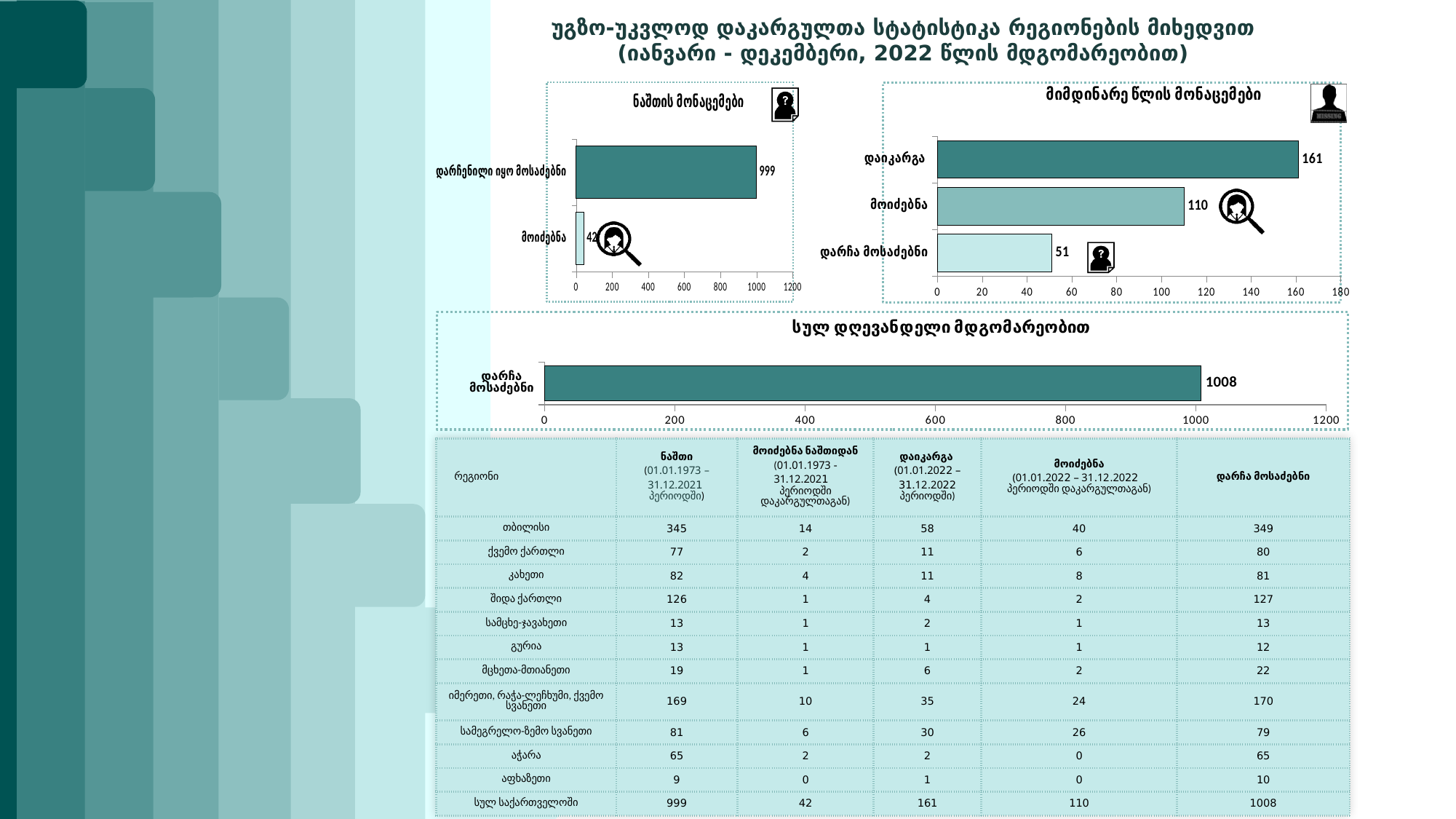
In the top-left chart titled "ნაშთის მონაცემები", what is the value for "მოიძებნა"? 42 In the top-right chart titled "მიმდინარე წლის მონაცემები", what is the difference between the values for "დაიკარგა" and "მოიძებნა"? 51 In the bottom chart titled "სულ დღევანდელი მდგომარეობით", what is the value for "დარჩა მოსაძებნი"? 1008 In the top-right chart titled "მიმდინარე წლის მონაცემები", which category has the highest value? დაიკარგა In the top-right chart titled "მიმდინარე წლის მონაცემები", is the value for "დარჩა მოსაძებნი" greater or less than 60? less In the top-right chart titled "მიმდინარე წლის მონაცემები", what is the value for "დაიკარგა"? 161 In the top-left chart titled "ნაშთის მონაცემები", what is the value for "დარჩენილი იყო მოსაძებნი"? 999 In the top-right chart titled "მიმდინარე წლის მონაცემები", how many categories are plotted? 3 In the top-left chart titled "ნაშთის მონაცემები", what is the difference between the values for "დარჩენილი იყო მოსაძებნი" and "მოიძებნა"? 957 In the top-right chart titled "მიმდინარე წლის მონაცემები", what is the value for "მოიძებნა"? 110 In the top-right chart titled "მიმდინარე წლის მონაცემები", which category has the lowest value? დარჩა მოსაძებნი What kind of chart is the bottom chart titled "სულ დღევანდელი მდგომარეობით"? bar chart